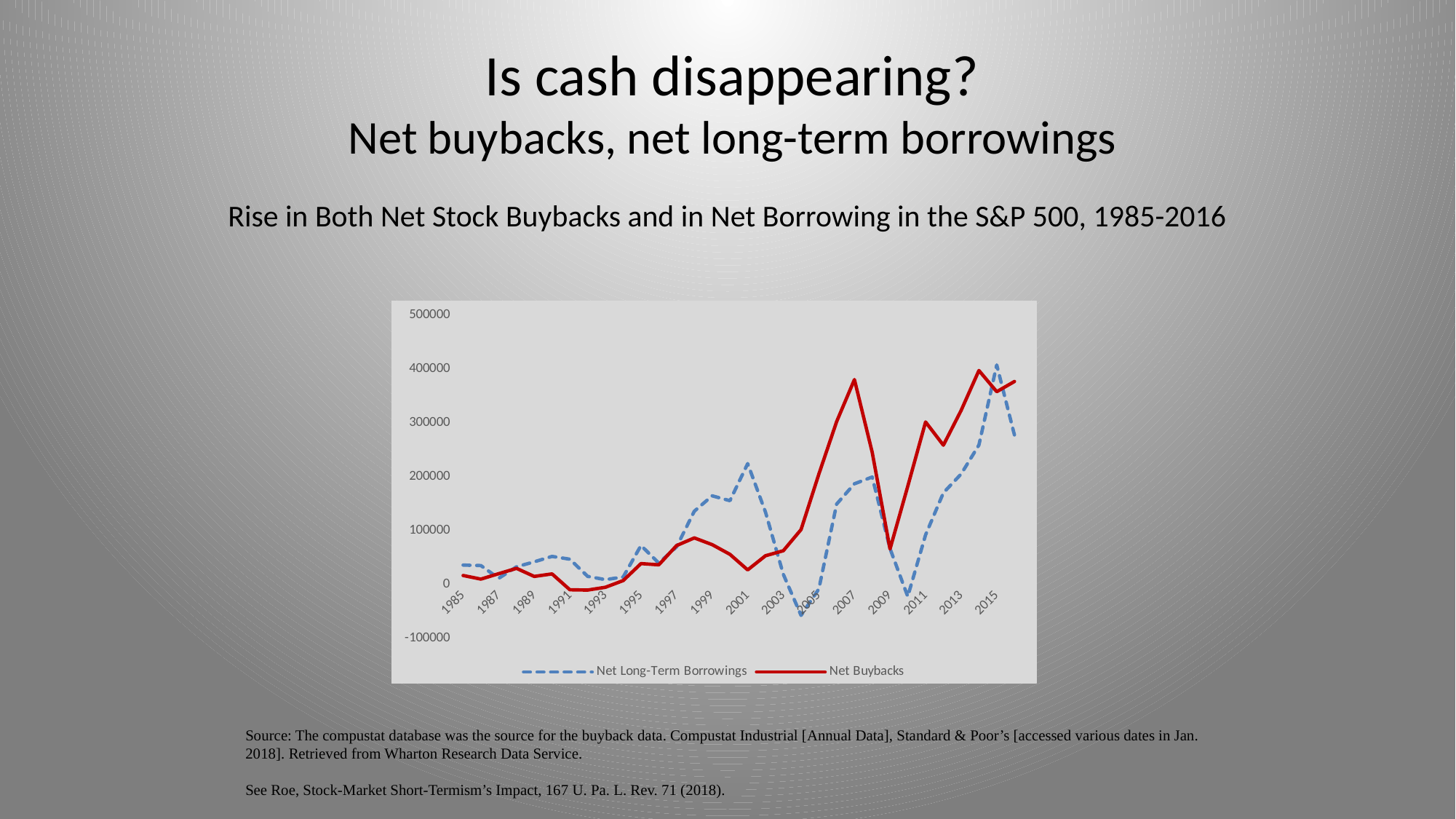
How many year labels are shown on the x axis? 16 Which series is drawn as a solid red line? Net Buybacks Is the value for Net Long-Term Borrowings in 2001 greater or less than 200000? greater Is the value for Net Buybacks in 2009 greater or less than 100000? less What are the two series named in the chart's legend? Net Long-Term Borrowings and Net Buybacks Is the value for Net Buybacks in 2007 greater or less than 300000? greater How many series does the chart's legend list? 2 In 1999, which series has the higher value, Net Buybacks or Net Long-Term Borrowings? Net Long-Term Borrowings In 2007, which series has the higher value, Net Buybacks or Net Long-Term Borrowings? Net Buybacks What kind of chart is shown on the slide? line chart Does the Net Buybacks line rise or fall between 2009 and 2014? rise